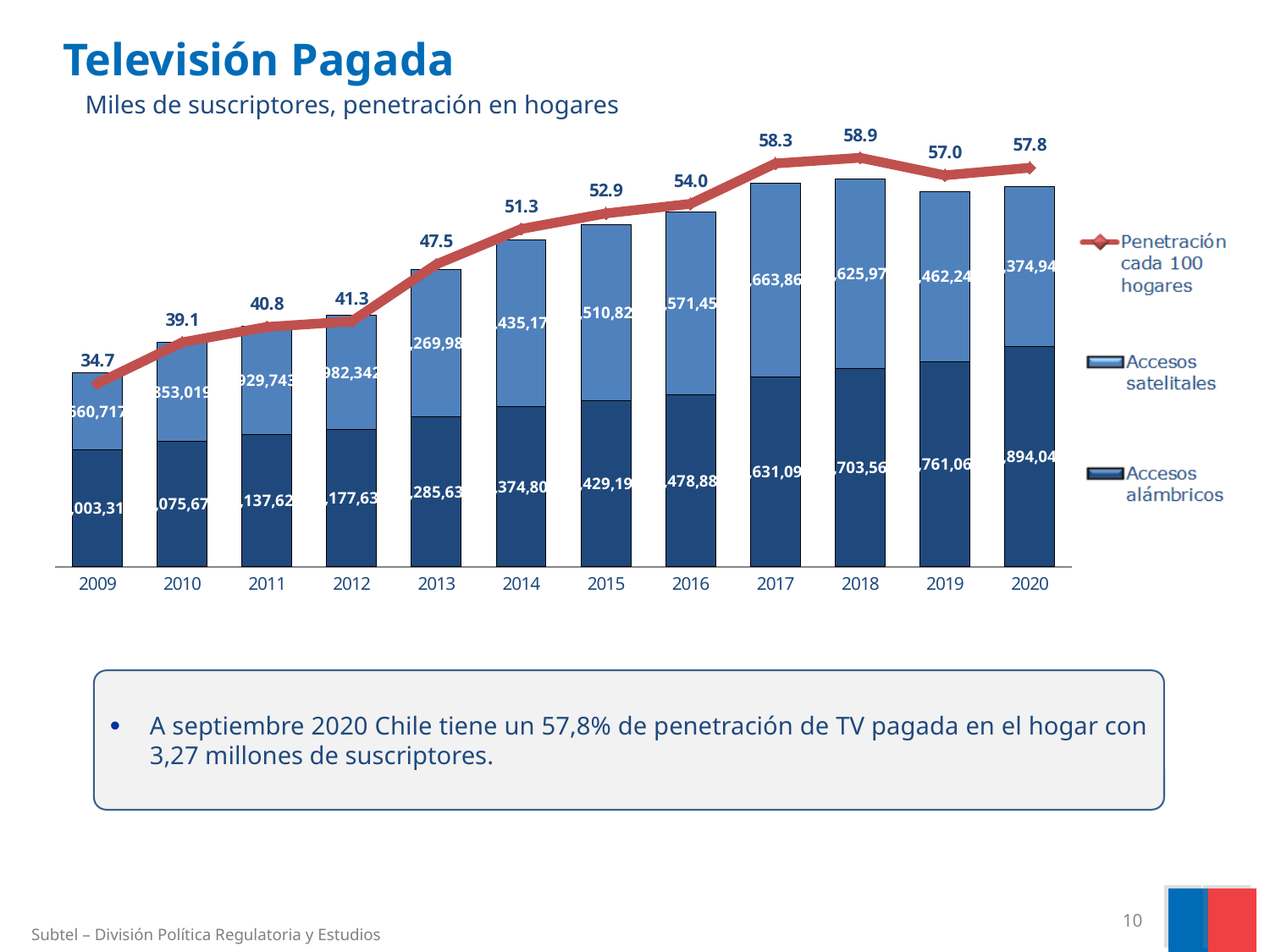
What is the penetration per 100 households value shown for 2014? 51.3 What is the penetration per 100 households value shown for 2009? 34.7 In which year is the penetration per 100 households highest? 2018 How many series does the chart legend list? 3 What kind of chart is used to show the subscriber data on this slide? Stacked bar chart with a line overlay Does the penetration per 100 households generally rise or fall from 2009 to 2018? Rise Which year has a higher penetration per 100 households, 2017 or 2020? 2017 By how much did the penetration per 100 households change between 2009 and 2020? 23.1 How many years are shown on the x axis of the chart? 12 What is the penetration per 100 households (Penetración cada 100 hogares) shown for 2020? 57.8 In which year is the penetration per 100 households lowest? 2009 What is the difference in penetration per 100 households between 2018 and 2019? 1.9